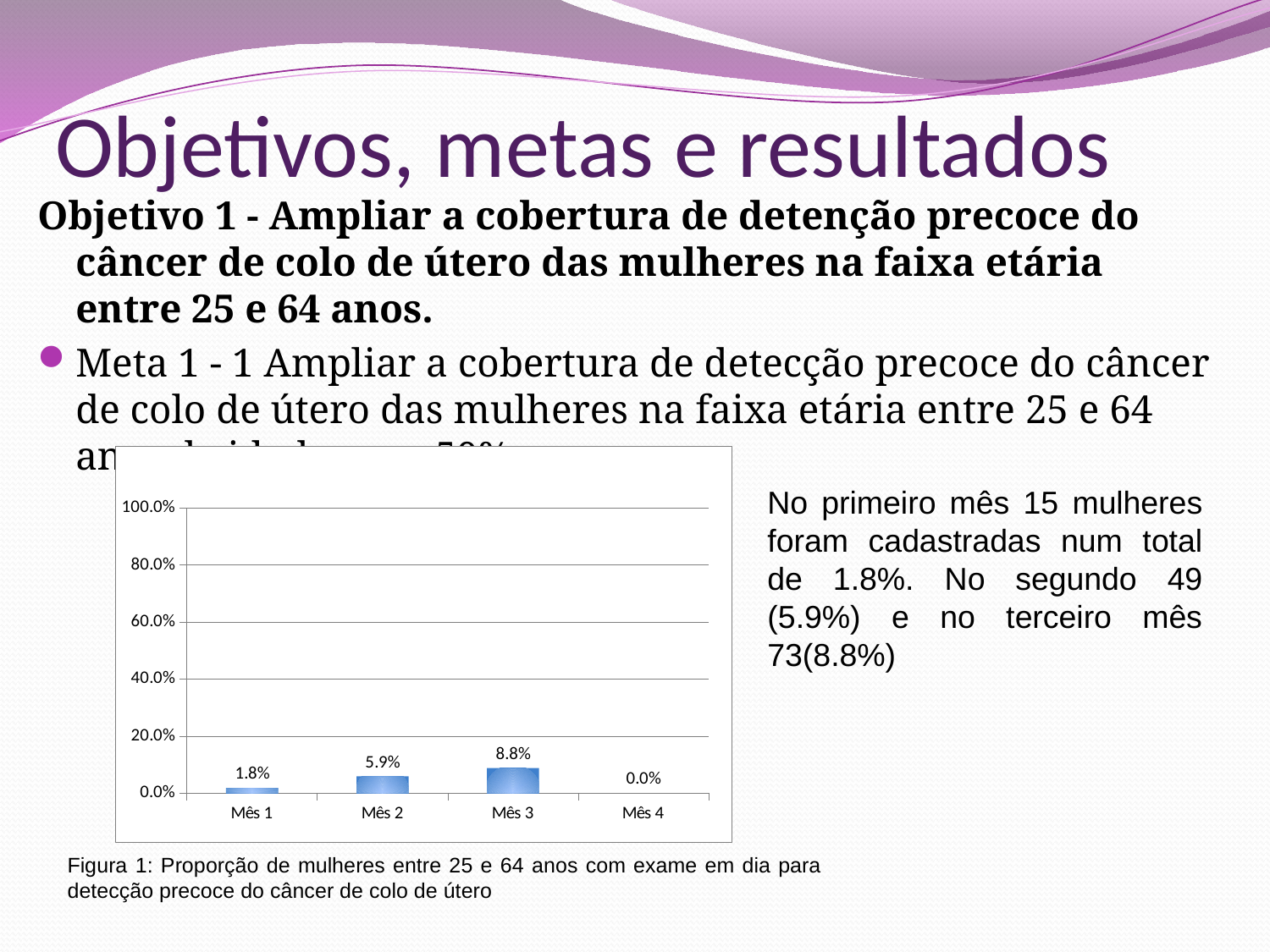
What is the value for Mês 2? 5.9% What is the value for Mês 3? 8.8% What is the value for Mês 4? 0.0% Which is larger, the value for Mês 2 or the value for Mês 3? Mês 3 What is the difference between the values for Mês 3 and Mês 1? 7.0% What is the value for Mês 1? 1.8% How many categories are shown on the x axis? 4 What is the difference between the values for Mês 2 and Mês 1? 4.1% What kind of chart is shown on the slide? bar chart Which month has the highest value? Mês 3 Is the value for Mês 3 greater or less than 20.0%? less Which month has the lowest value? Mês 4